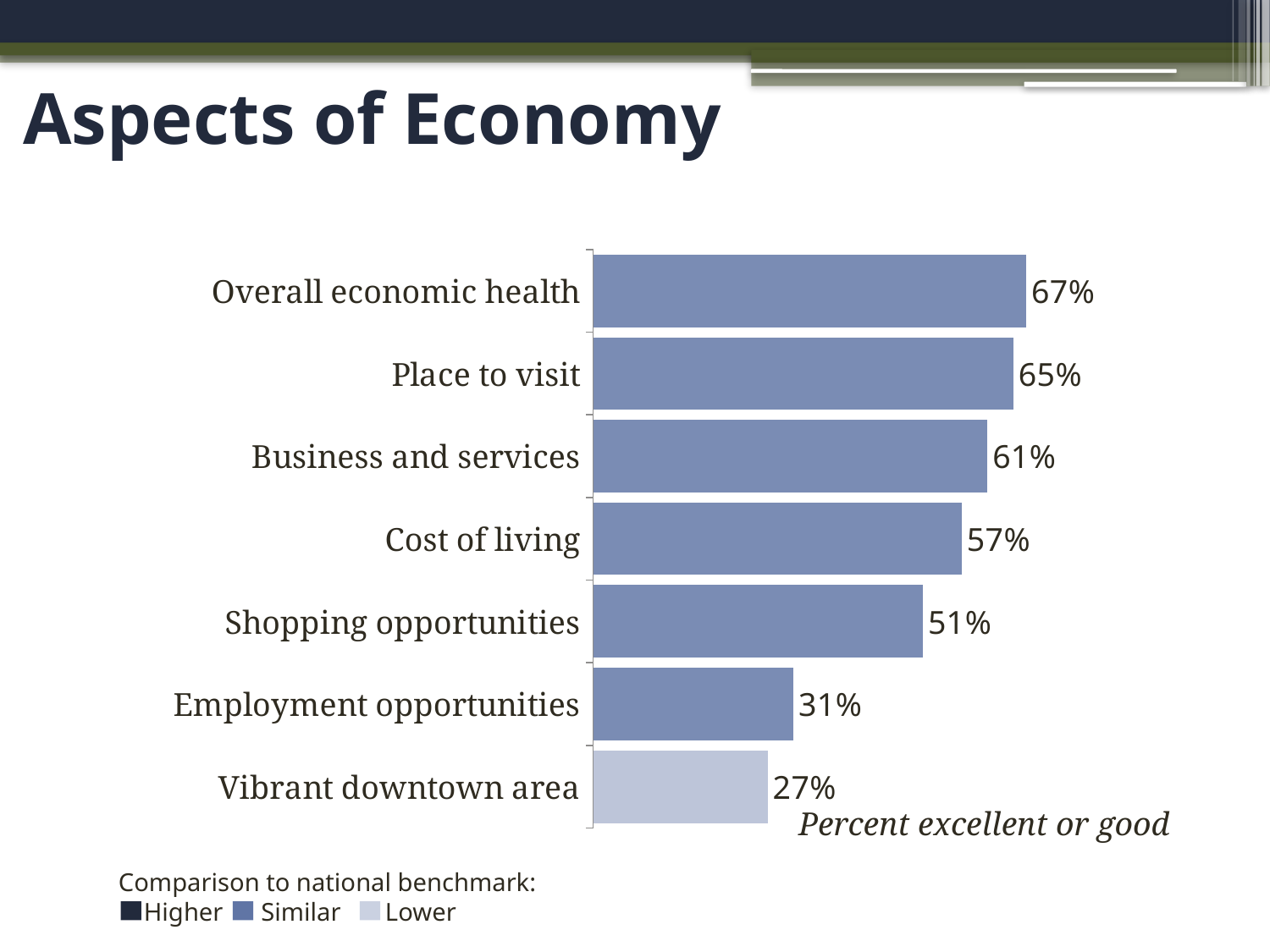
How many categories does the comparison-to-national-benchmark legend list? 3 What is the value for Cost of living? 57% How many aspects of the economy are shown in the chart? 7 Which aspect of the economy has the lowest percentage rating? Vibrant downtown area What is the difference between the values for Employment opportunities and Vibrant downtown area? 4% What is the difference between the values for Place to visit and Shopping opportunities? 14% What is the value for Employment opportunities? 31% What percentage rated overall economic health as excellent or good? 67% What kind of chart is shown on the slide? Bar chart Which aspect is shaded as lower than the national benchmark? Vibrant downtown area Which is larger, the value for Business and services or the value for Cost of living? Business and services Which aspect of the economy has the highest percentage rating? Overall economic health